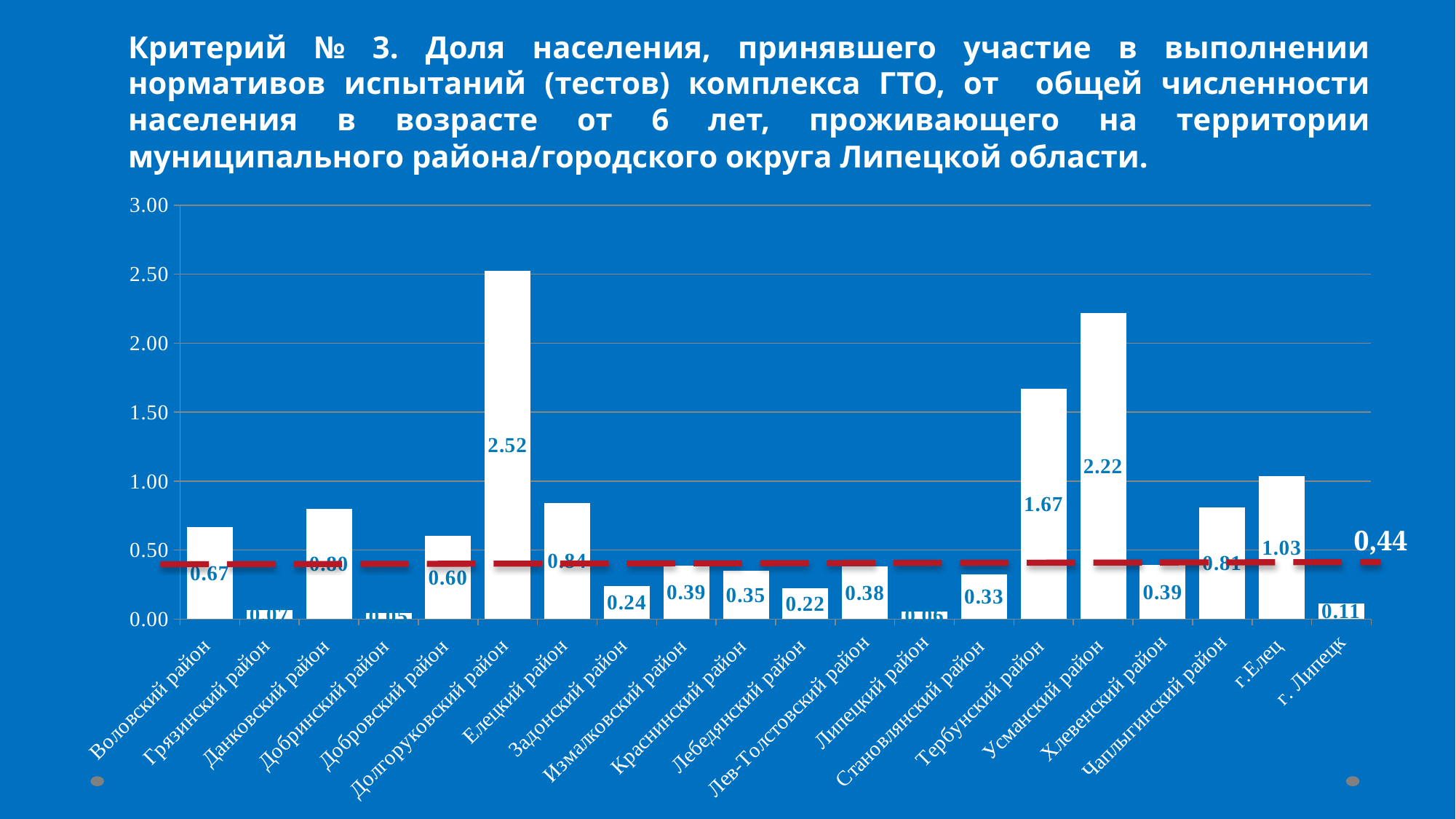
What value is labelled on the red dashed horizontal line? 0,44 What is the value for г.Елец? 1.03 What is the value for Задонский район? 0.24 Which is larger, the value for Чаплыгинский район or the value for Воловский район? Чаплыгинский район What is the difference between the values for Долгоруковский район and Усманский район? 0.30 What is the value for Усманский район? 2.22 How many categories are shown on the x axis? 20 What type of chart is shown on the slide? bar chart What is the difference between the values for Тербунский район and г.Елец? 0.64 Which category has the highest value? Долгоруковский район What is the value for Долгоруковский район? 2.52 Is the value for Тербунский район greater or less than 1.50? greater